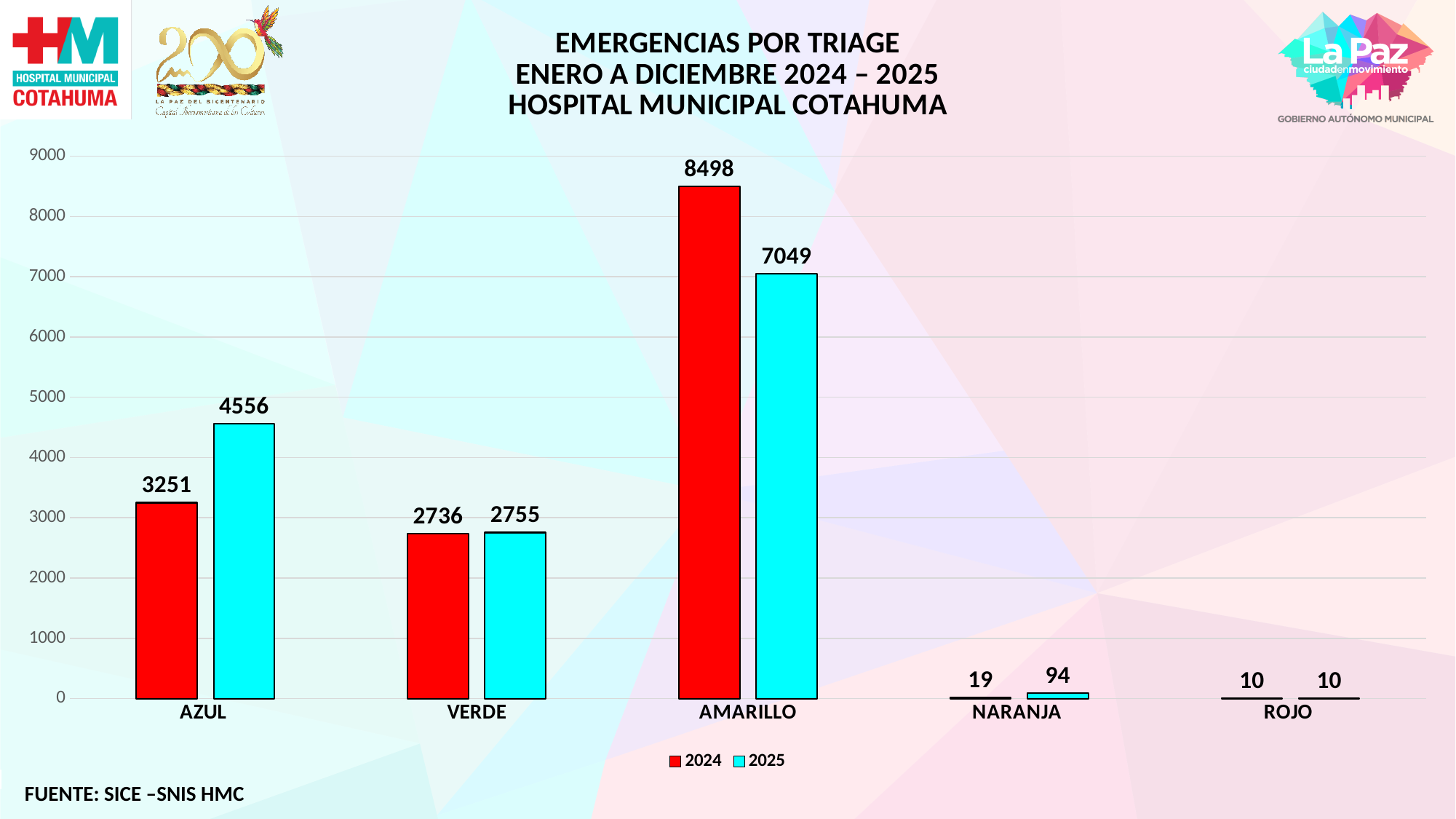
Which category has the highest value in 2024? AMARILLO How many triage categories are shown on the x axis? 5 What kind of chart is shown on the slide? bar chart What is the difference between the 2024 and 2025 values for AMARILLO? 1449 Which category has the lowest value in 2025? ROJO What is the value for AMARILLO in 2024? 8498 What colour represents the 2025 series in the legend? cyan What is the value for ROJO in 2024? 10 Which is larger for AZUL, the 2024 value or the 2025 value? 2025 What is the value for NARANJA in 2025? 94 What is the value for AZUL in 2025? 4556 How many series does the legend list? 2